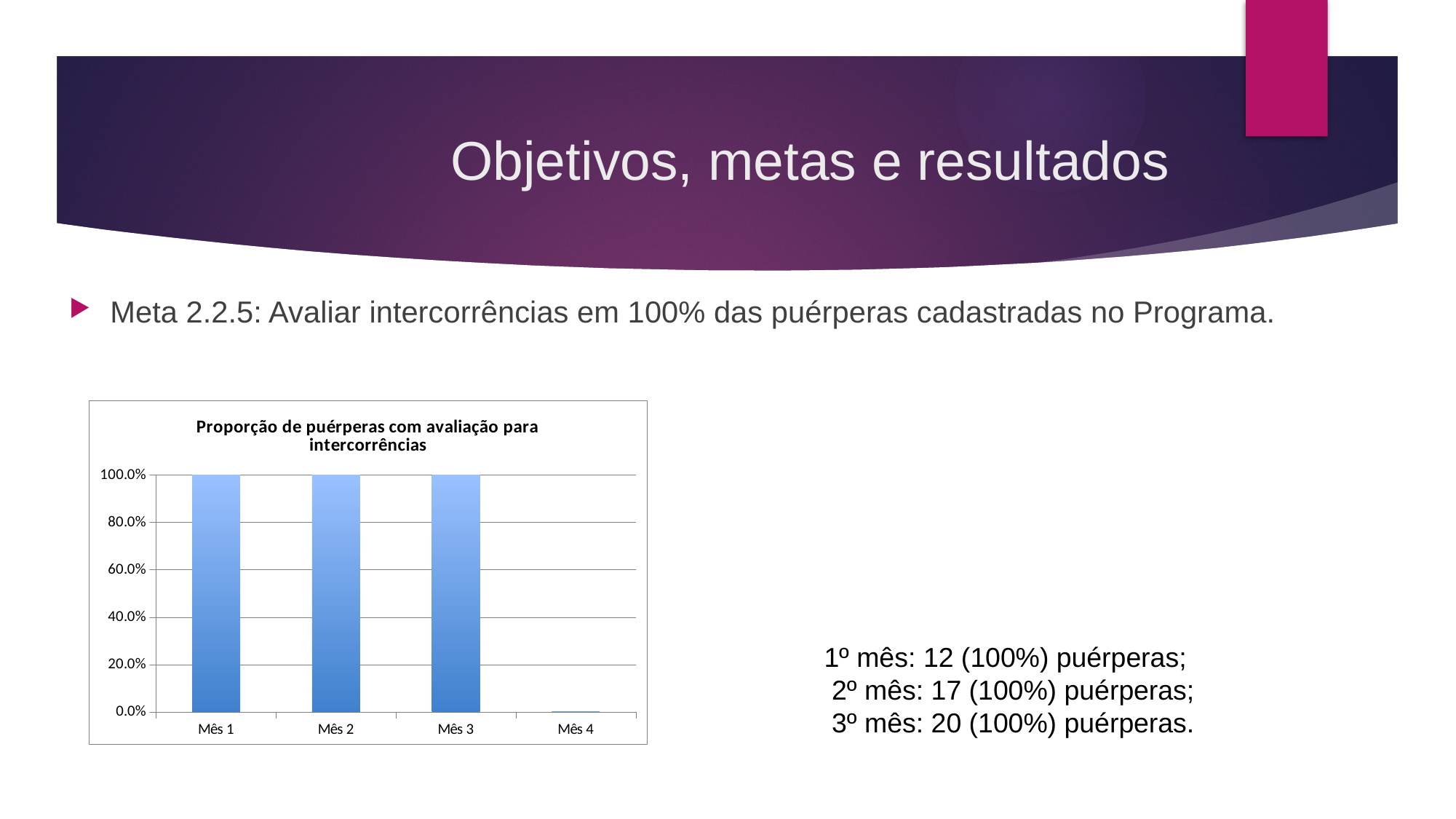
What is the title of the chart? Proporção de puérperas com avaliação para intercorrências Which category has the lowest value? Mês 4 What kind of chart is shown on the slide? bar chart Which is larger, the value for Mês 1 or the value for Mês 4? Mês 1 What is the value for Mês 2? 100.0% What is the value for Mês 3? 100.0% Is the value for Mês 4 greater or less than 20.0%? less What is the difference between the value for Mês 3 and the value for Mês 4? 100.0% What is the value for Mês 1? 100.0% What is the value for Mês 4? 0.0% How many categories are shown on the x axis of the chart? 4 Is the value for Mês 2 greater or less than 80.0%? greater